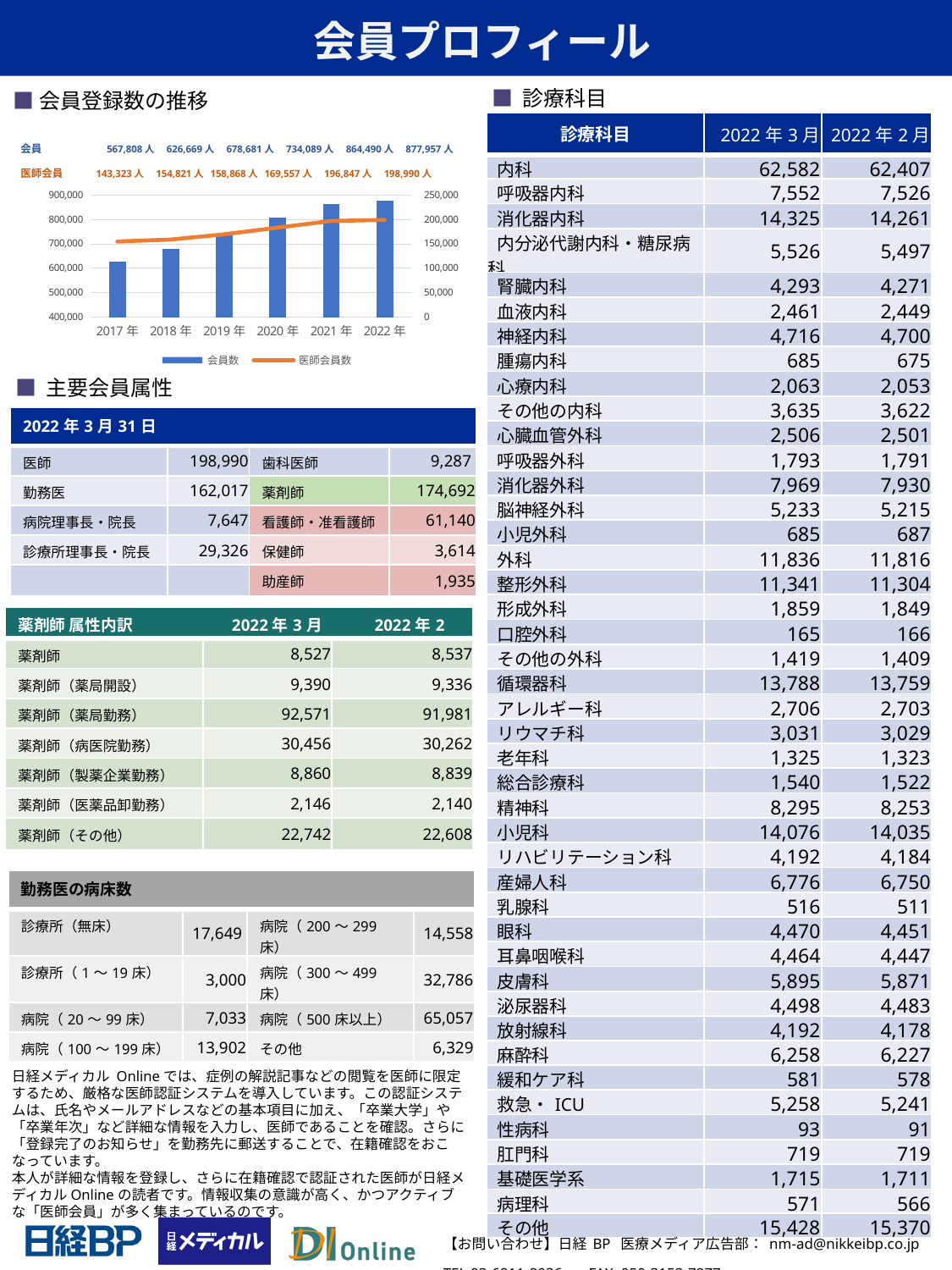
In the 会員登録数の推移 chart, which year has the highest 医師会員 value? 2022年 How many years are shown on the x axis of the 会員登録数の推移 chart? 6 In the 会員登録数の推移 chart, do the 会員 values rise or fall from 2017年 to 2022年? rise In the 会員登録数の推移 chart, what is the 会員 value for 2022年? 877,957人 In the 会員登録数の推移 chart, which year has the lowest 会員 value? 2017年 In the 会員登録数の推移 chart, is the 会員 bar for 2017年 greater or less than 600,000? greater How many series does the legend of the 会員登録数の推移 chart list? 2 In the 会員登録数の推移 chart, is the 会員 value for 2020年 larger than the 会員 value for 2018年? Yes In the 会員登録数の推移 chart, what kind of chart is used to show 会員数? bar chart